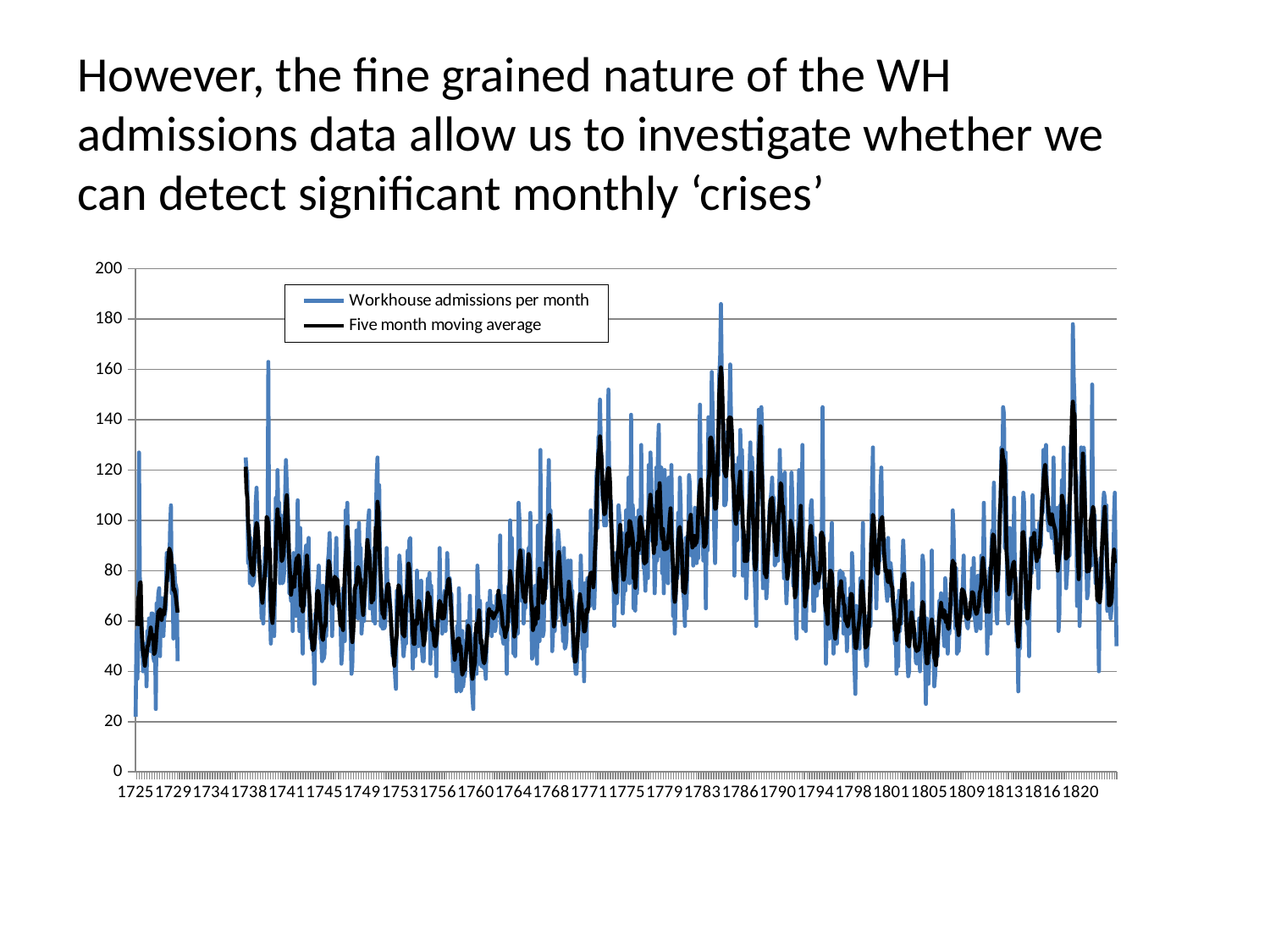
Is the peak of the Workhouse admissions per month series near 1740 greater or less than 140? greater Is the highest peak of the Five month moving average (around 1785) greater or less than 140? greater Is the Five month moving average around 1805 greater or less than 80? less What is the highest value shown on the vertical axis? 200 Which series is drawn as the black line? Five month moving average How many series does the legend list? 2 Which series reaches higher peaks, Workhouse admissions per month or Five month moving average? Workhouse admissions per month What kind of chart is shown on the slide? line chart